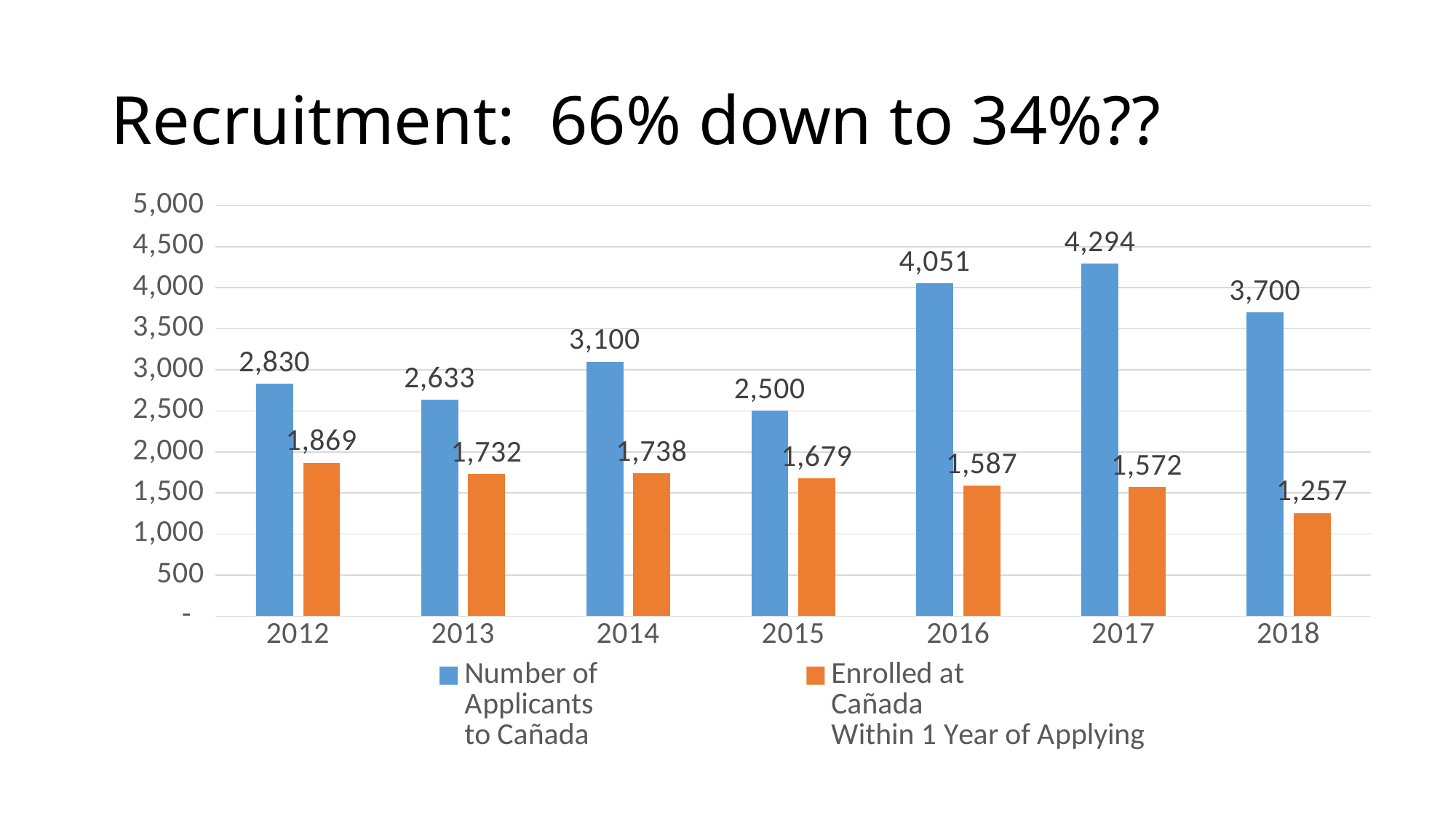
Which year has the lowest value for Enrolled at Cañada Within 1 Year of Applying? 2018 How many students were Enrolled at Cañada Within 1 Year of Applying in 2012? 1,869 How many years are shown on the x axis? 7 What is the difference between the Number of Applicants to Cañada and the number Enrolled at Cañada Within 1 Year of Applying in 2018? 2,443 What is the title of the slide? Recruitment: 66% down to 34%?? What is the Number of Applicants to Cañada in 2016? 4,051 What kind of chart is shown on the slide? bar chart Which is larger: the Number of Applicants to Cañada in 2014 or in 2015? 2014 Does the number Enrolled at Cañada Within 1 Year of Applying generally rise or fall from 2012 to 2018? fall How many series does the legend list? 2 Which year has the highest Number of Applicants to Cañada? 2017 Is the Number of Applicants to Cañada in 2013 greater or less than 3,000? less